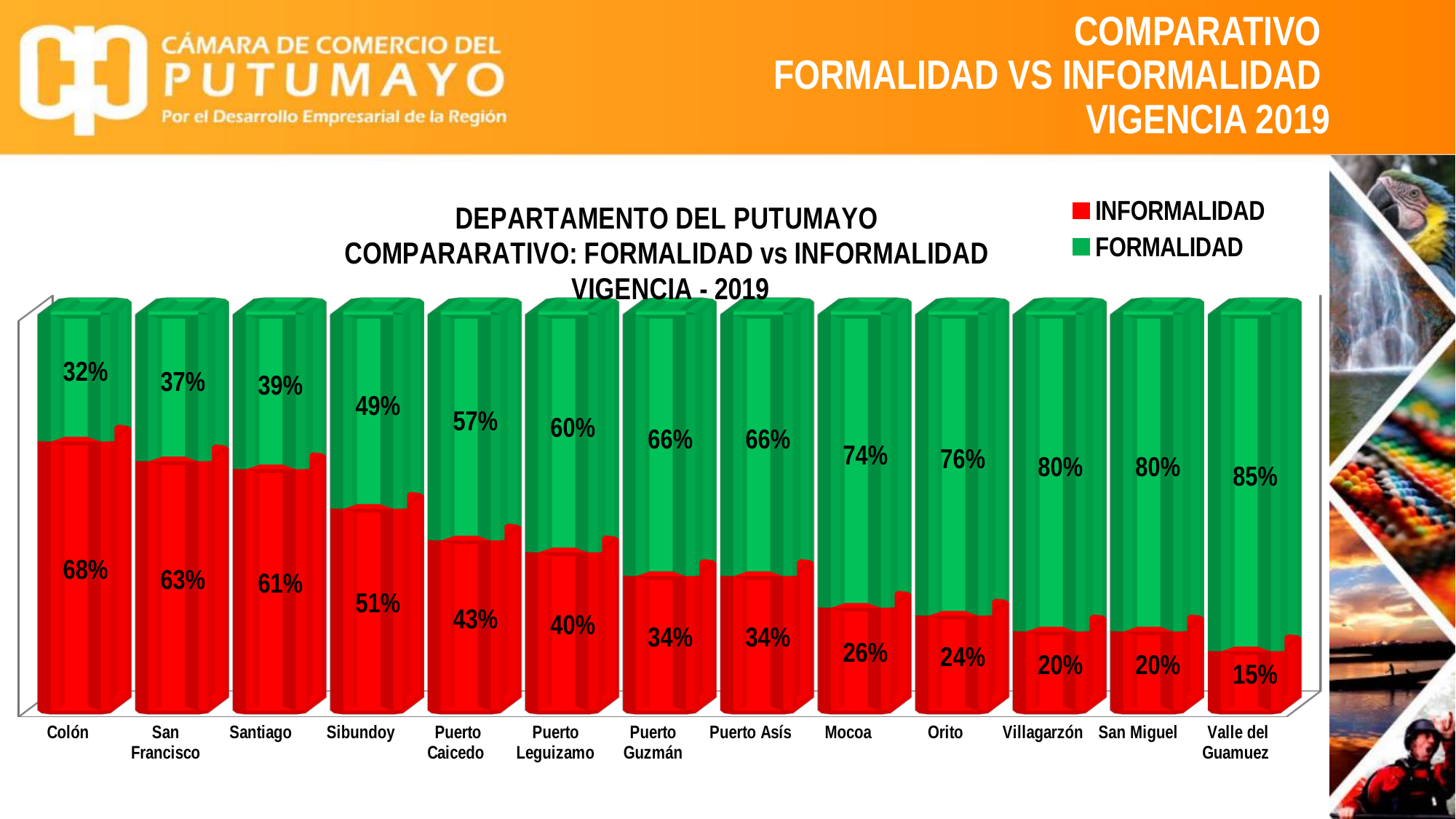
What is the INFORMALIDAD value for Colón? 68% What is the difference between the FORMALIDAD values for Orito and Santiago? 37% How many municipalities are shown on the x axis? 13 Which municipality has the highest INFORMALIDAD value? Colón What is the INFORMALIDAD value for Sibundoy? 51% What is the FORMALIDAD value for Valle del Guamuez? 85% What kind of chart is shown on the slide? Stacked bar chart Which colour represents FORMALIDAD in the legend? Green How many series does the legend list? 2 Which is larger, the INFORMALIDAD value for Puerto Caicedo or for Puerto Leguizamo? Puerto Caicedo Which municipality has the lowest FORMALIDAD value? Colón What is the FORMALIDAD value for Mocoa? 74%